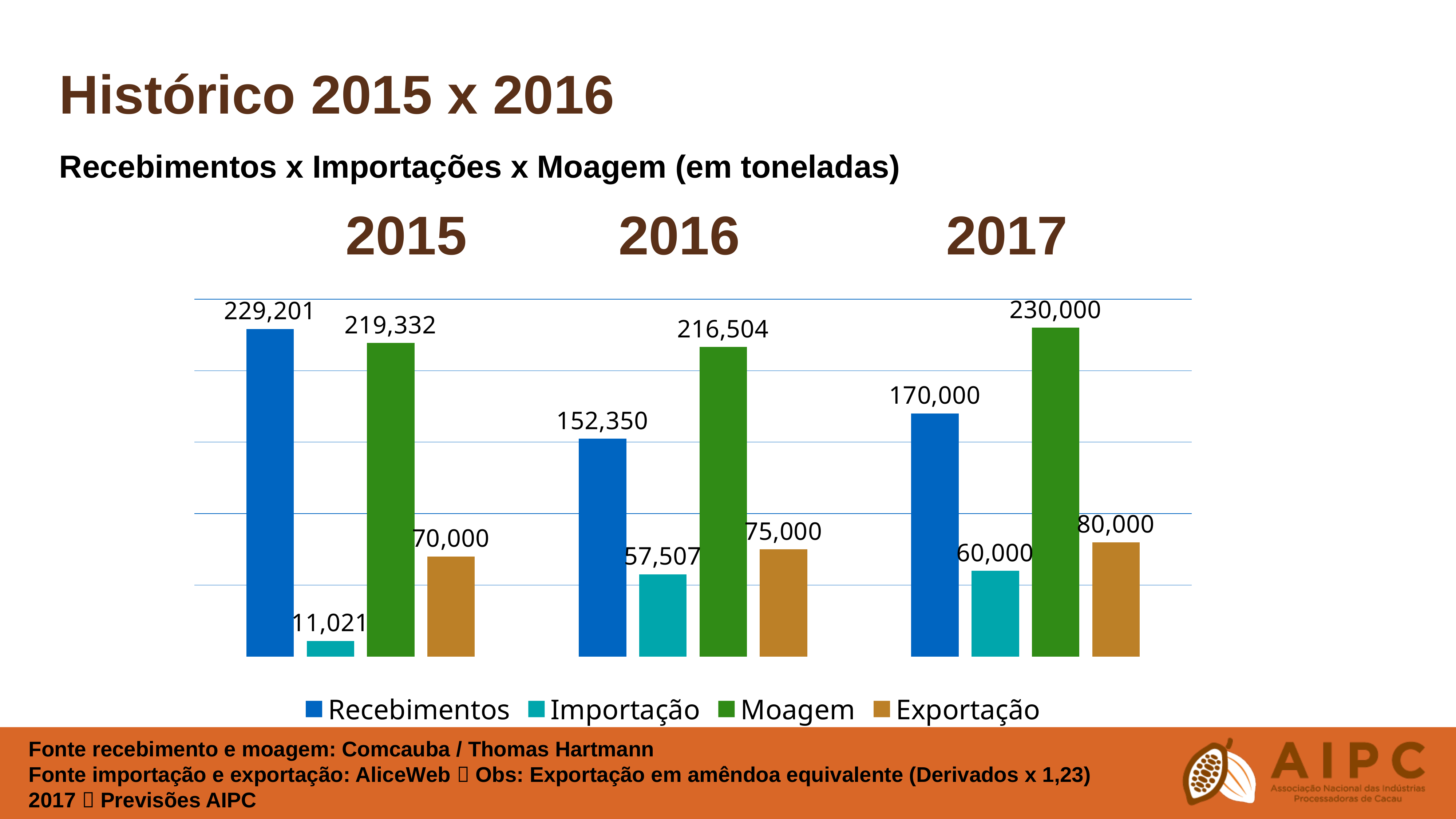
What is the value of Exportação for 2015? 70,000 How many years are shown on the x axis? 3 What kind of chart is shown on the slide? Bar chart Does Exportação rise or fall from 2015 to 2017? Rise Which is larger in 2016, Recebimentos or Moagem? Moagem What is the value of Moagem for 2017? 230,000 What is the value of Importação for 2016? 57,507 In which year is Moagem highest? 2017 In which year is Importação lowest? 2015 What is the value of Recebimentos for 2015? 229,201 What is the difference between Recebimentos in 2015 and Recebimentos in 2016? 76,851 How many series does the legend list? 4